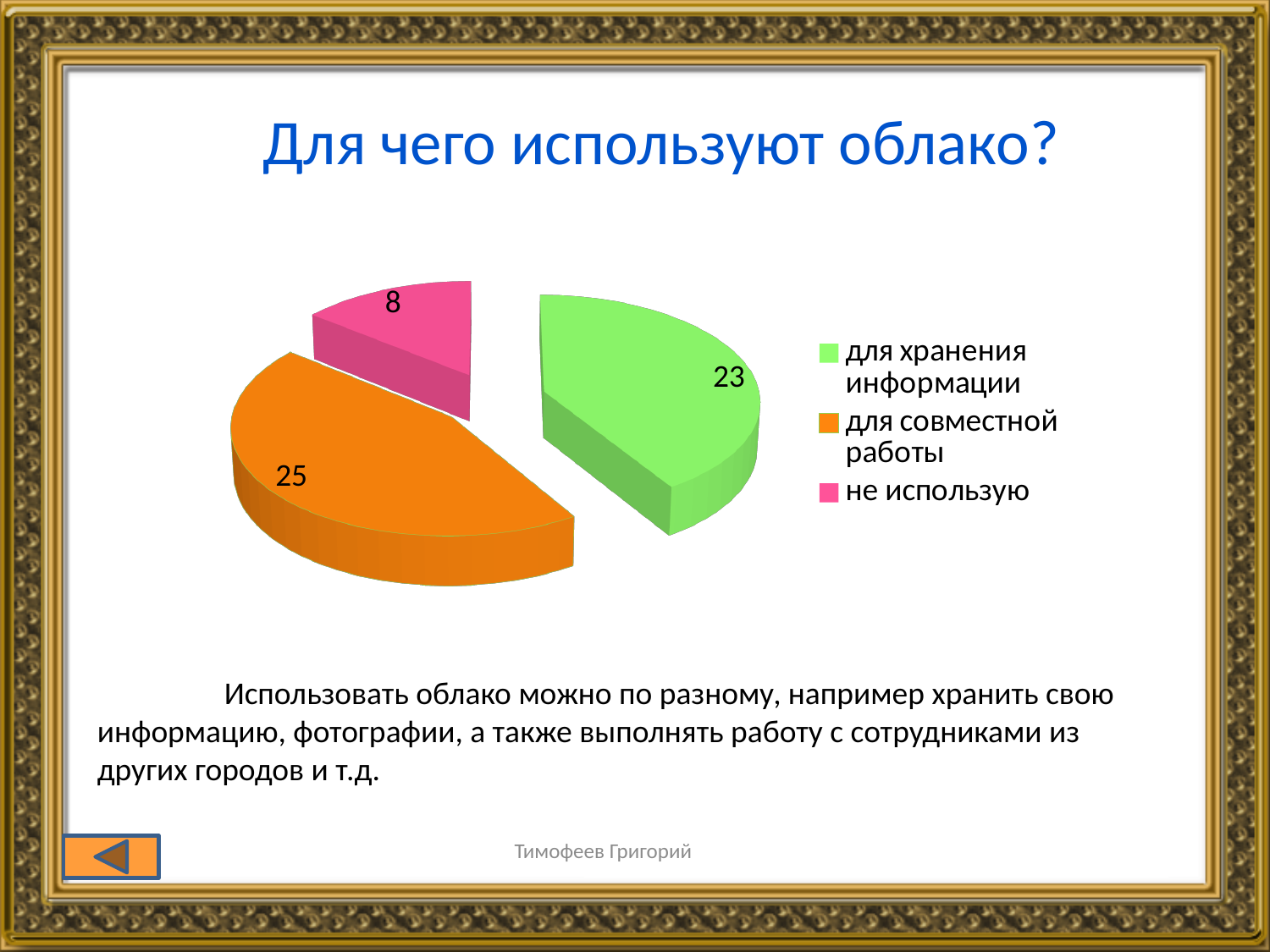
What is the difference between the values for "для хранения информации" and "не использую"? 15 What is the value for "для хранения информации"? 23 How many slices does the pie chart have? 3 Which category has the smallest slice? не использую Which is larger: "для хранения информации" or "не использую"? для хранения информации What kind of chart is shown on the slide? Pie chart What is the difference between the values for "для совместной работы" and "для хранения информации"? 2 Which category has the largest slice? для совместной работы What is the value for "не использую"? 8 What is the value for "для совместной работы"? 25 What is the title of the slide containing the chart? Для чего используют облако? What is the total of all slices in the pie chart? 56